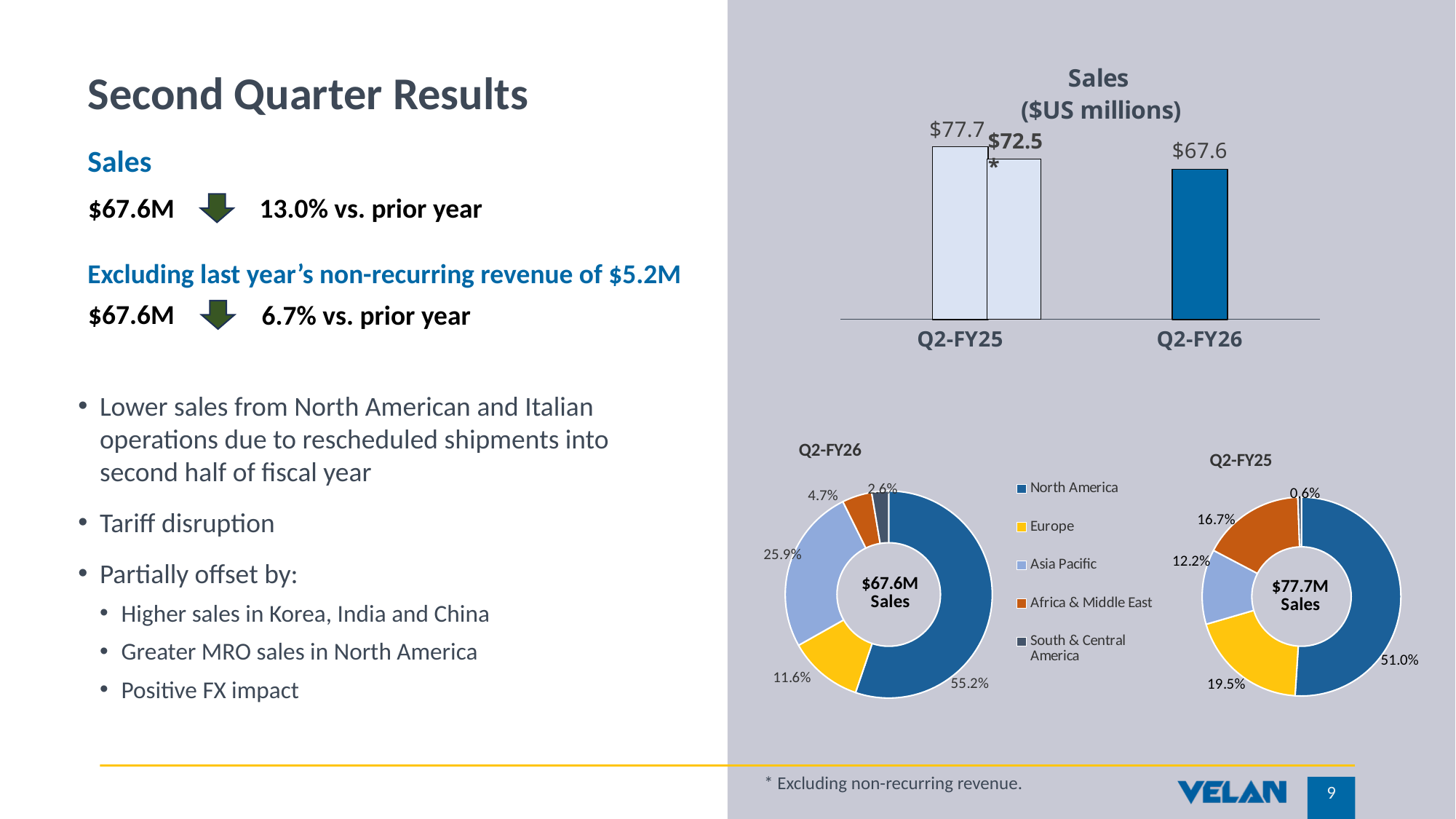
What kind of chart is the Sales ($US millions) chart at the top right? Bar chart In the Q2-FY25 donut chart, what share of sales comes from Africa & Middle East? 16.7% In the Sales ($US millions) bar chart, which quarter has the lower sales value? Q2-FY26 In the Sales ($US millions) bar chart, what is the value of the first (unadjusted) Q2-FY25 bar? $77.7 In the Sales ($US millions) bar chart, what is the value of the Q2-FY26 bar? $67.6 In the Q2-FY25 donut chart, which region has the smallest share of sales? South & Central America Which is larger: the Europe share in the Q2-FY25 donut chart or the Europe share in the Q2-FY26 donut chart? Q2-FY25 (19.5%) In the Sales ($US millions) bar chart, what is the difference between the unadjusted Q2-FY25 value and the Q2-FY26 value? $10.1 How many regions does the legend shared by the two donut charts list? 5 In the Q2-FY26 donut chart, what share of sales comes from North America? 55.2% In the Q2-FY26 donut chart, what share of sales comes from Asia Pacific? 25.9% In the Sales ($US millions) bar chart, what is the value of the Q2-FY25 bar marked with an asterisk (excluding non-recurring revenue)? $72.5